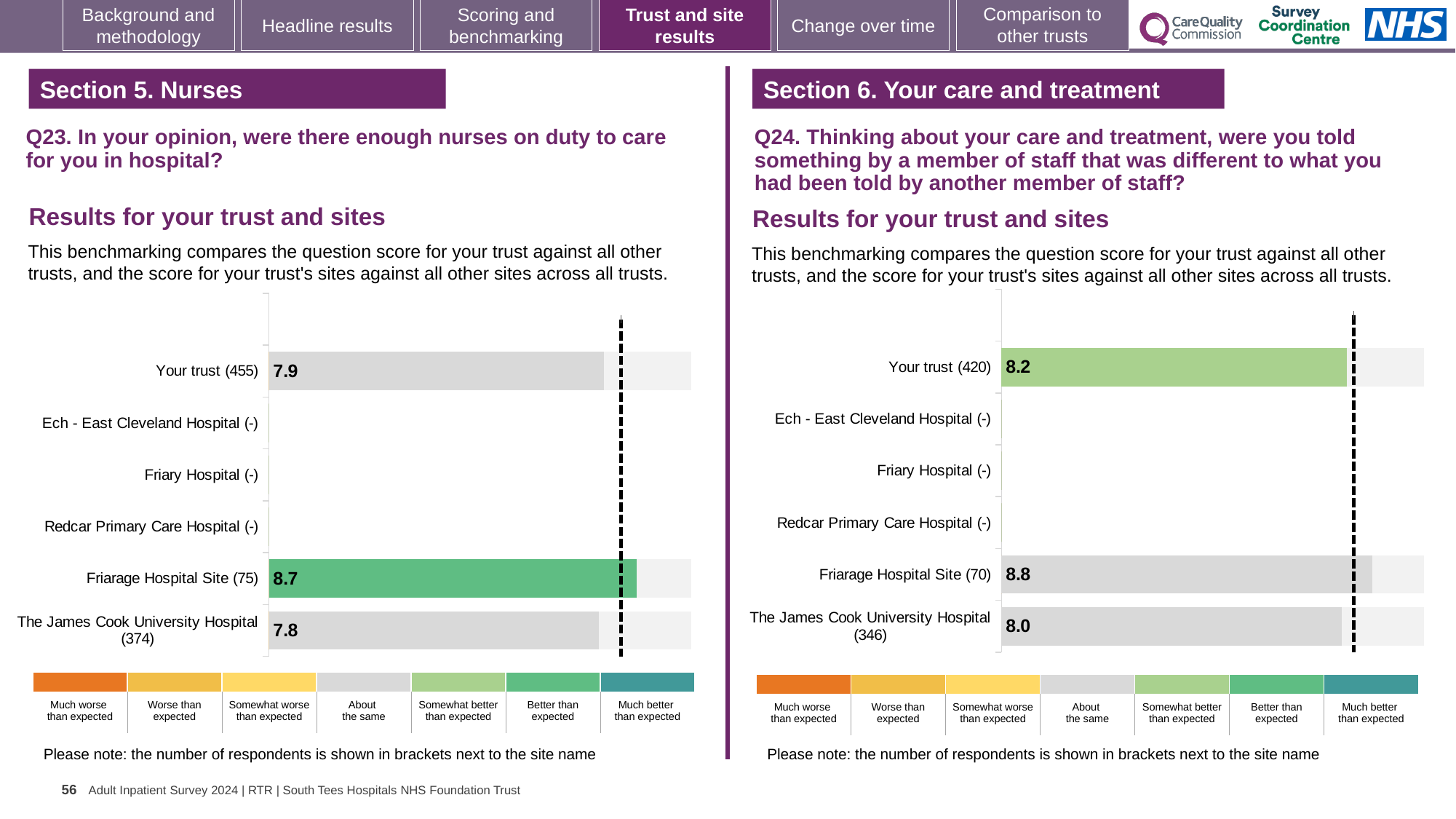
In the Q23 chart on the left, what is the score for The James Cook University Hospital (374)? 7.8 In the Q24 chart on the right, is the score for Your trust (420) larger or smaller than the score for Friarage Hospital Site (70)? smaller In the Q24 chart on the right, what is the score for Your trust (420)? 8.2 In the Q23 chart on the left, what is the score for Your trust (455)? 7.9 In the Q23 chart on the left, which site has the highest score? Friarage Hospital Site (75) What kind of chart is used in the Q23 chart on the left? Bar chart In the Q24 chart on the right, what is the score for The James Cook University Hospital (346)? 8.0 In the Q23 chart on the left, what is the difference between the Friarage Hospital Site score and The James Cook University Hospital score? 0.9 In the Q24 chart on the right, what is the difference between the Friarage Hospital Site score and the Your trust score? 0.6 In the Q23 chart on the left, what is the score for Friarage Hospital Site (75)? 8.7 In the Q24 chart on the right, what is the score for Friarage Hospital Site (70)? 8.8 In the Q24 chart on the right, which site has the lowest score among those with a plotted bar? The James Cook University Hospital (346)